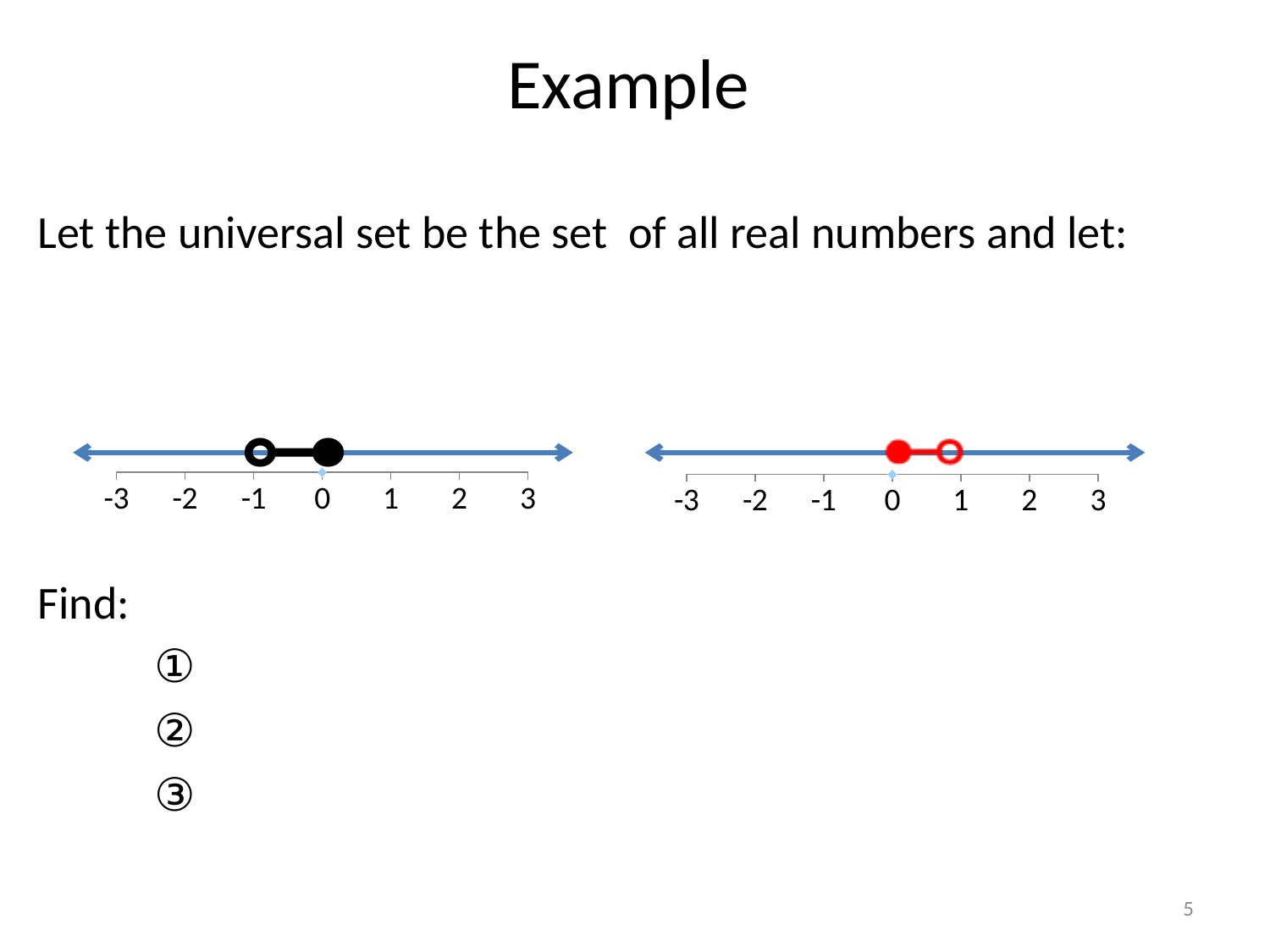
What is the largest tick label shown on the right number line? 3 How many tick labels are printed on the left number line? 7 What colour is the highlighted interval on the right number line? Red On the right number line, at which tick does the open (hollow) endpoint sit? 1 On the left number line, at which tick does the open (hollow) endpoint sit? -1 What colour is the highlighted interval on the left number line? Black What is the smallest tick label shown on the left number line? -3 On the right number line, at which tick does the filled (closed) endpoint sit? 0 On the left number line, at which tick does the filled (closed) endpoint sit? 0 How many number lines are shown on the slide? 2